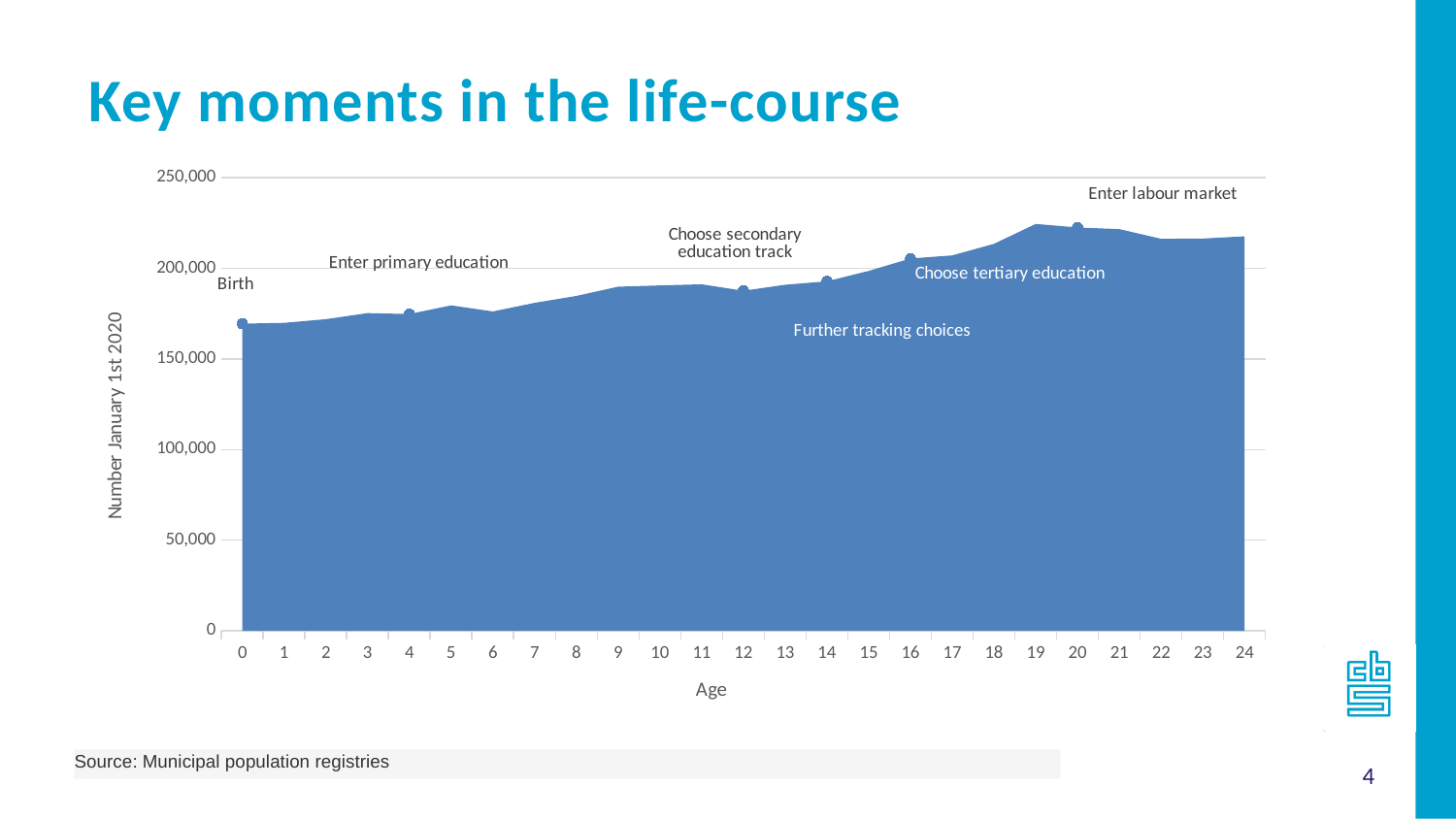
Is the value at age 0 greater or less than 200,000? less What is the title of the slide containing the chart? Key moments in the life-course Which is larger, the value at age 20 or the value at age 0? Age 20 How many ages are shown along the x axis of the chart? 25 Do the values generally rise or fall from age 0 to age 19? Rise Is the value at age 0 greater or less than 150,000? greater What kind of chart is shown on the slide? Area chart Which is larger, the value at age 16 or the value at age 4? Age 16 Is the value at age 12 greater or less than 200,000? less Which age has the lowest value in the chart? 0 What is the label on the vertical axis of the chart? Number January 1st 2020